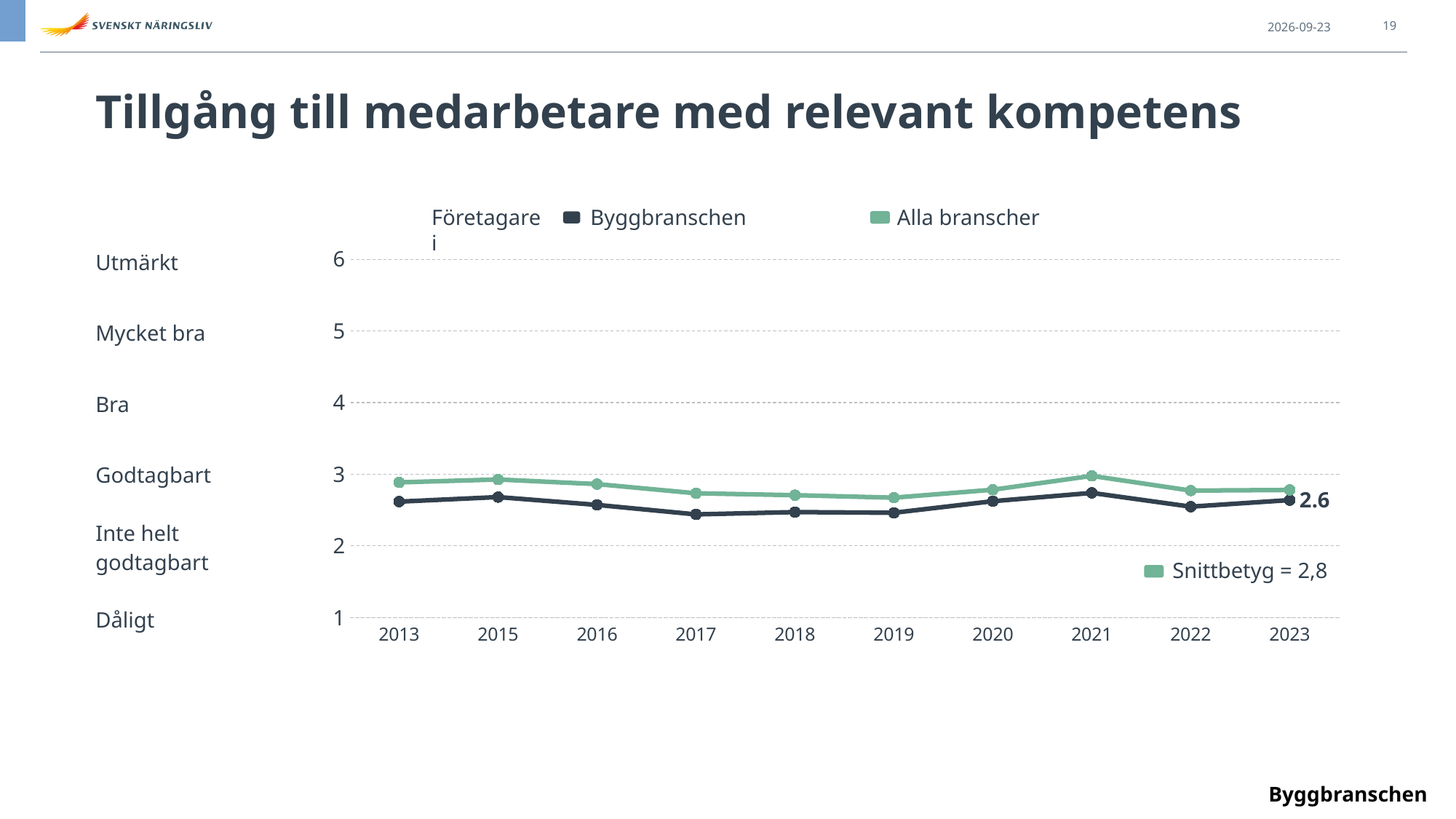
Is the value for Byggbranschen in 2017 greater or less than 3? less How many years are plotted along the x axis? 10 What is the title of the chart on the slide? Tillgång till medarbetare med relevant kompetens What kind of chart is shown on the slide? line chart Is the value for Alla branscher in 2013 greater or less than 2? greater What is the value for Byggbranschen in 2023? 2.6 How many series does the chart legend list? 2 Is the value for Byggbranschen in 2019 greater or less than 3? less Does the Alla branscher line rise or fall from 2015 to 2019? fall What Snittbetyg value is shown next to the chart? 2,8 Does the Byggbranschen line rise or fall from 2019 to 2021? rise In 2017, which series has the higher value, Byggbranschen or Alla branscher? Alla branscher